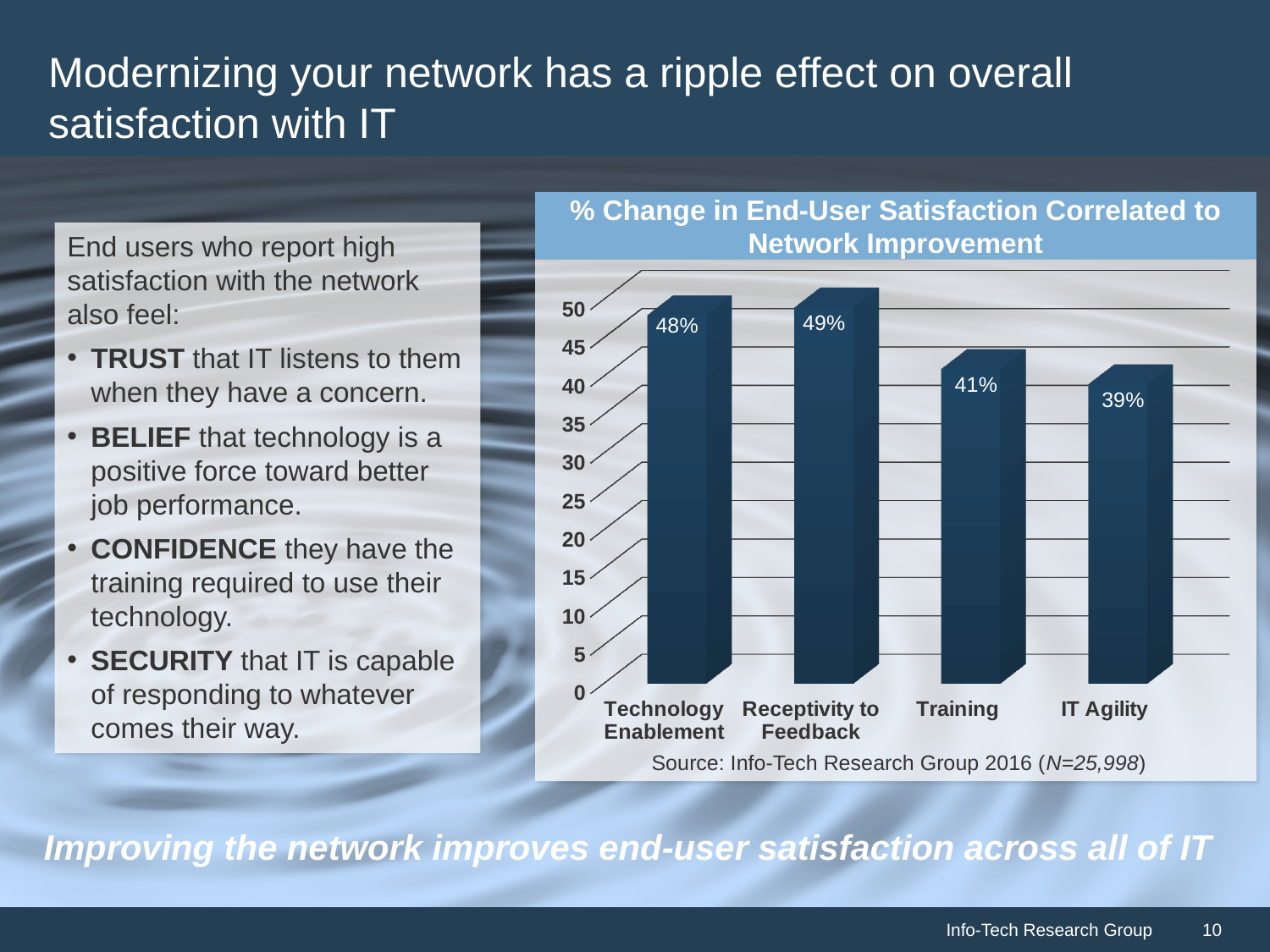
Which category has the highest value? Receptivity to Feedback What is the difference between the values for Technology Enablement and Training? 7% How many categories are shown on the chart? 4 What is the value for Training? 41% What is the value for Receptivity to Feedback? 49% Which is larger, the value for Training or the value for IT Agility? Training What is the value for IT Agility? 39% What kind of chart is shown on the slide? Bar chart What is the difference between the values for Receptivity to Feedback and IT Agility? 10% What is the title of the chart? % Change in End-User Satisfaction Correlated to Network Improvement What is the value for Technology Enablement? 48% Which category has the lowest value? IT Agility